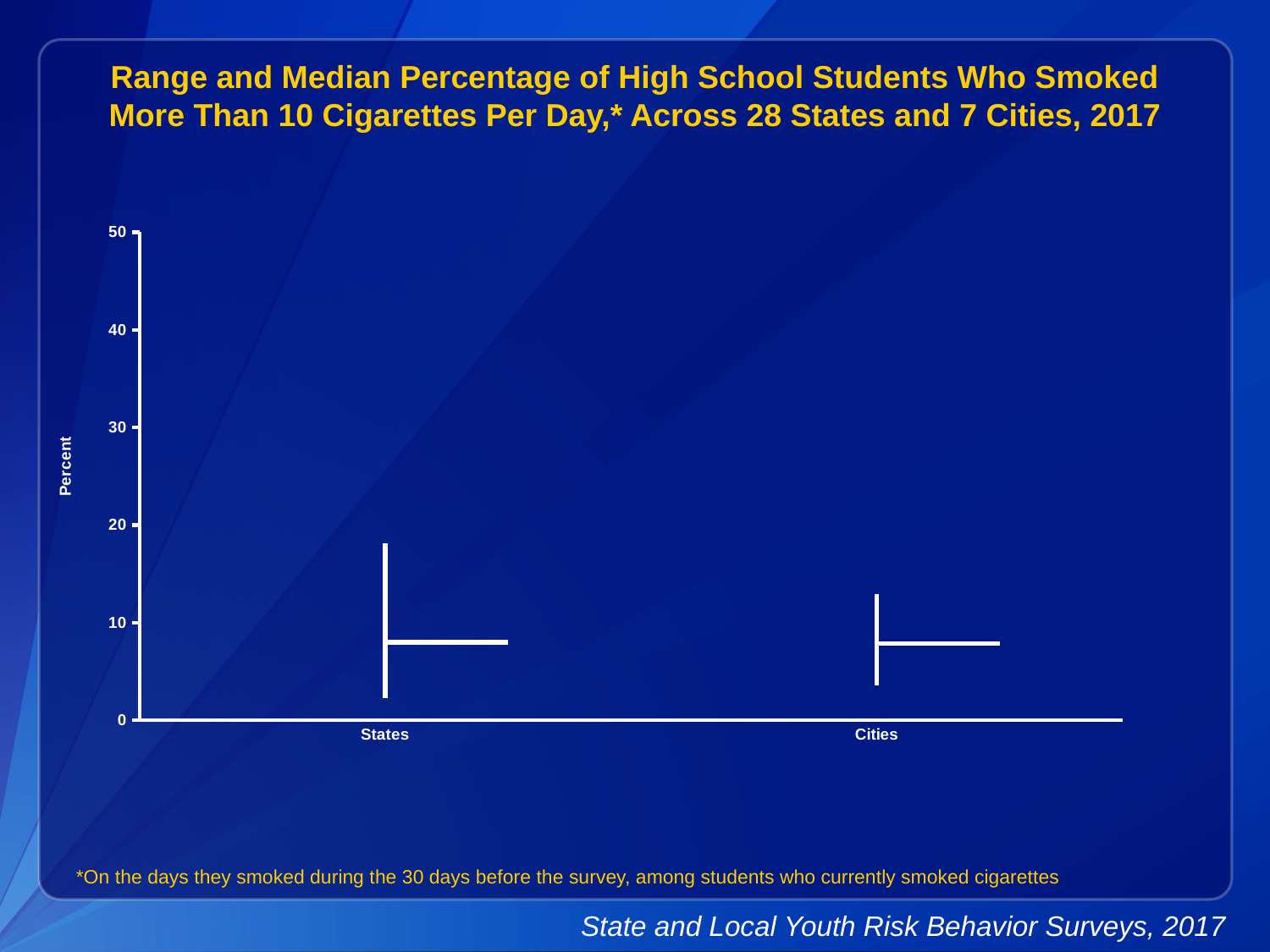
Is the upper end of the range for States greater or less than 10? greater What are the two categories shown on the x axis? States and Cities Is the median value for Cities greater or less than 10? less Is the median value for States greater or less than 10? less How many categories are shown on the x axis of the chart? 2 Which category has the lower bottom end of its range, States or Cities? States What is the highest value shown on the y axis? 50 Which category has the higher upper end of its range, States or Cities? States What is the label of the y axis? Percent